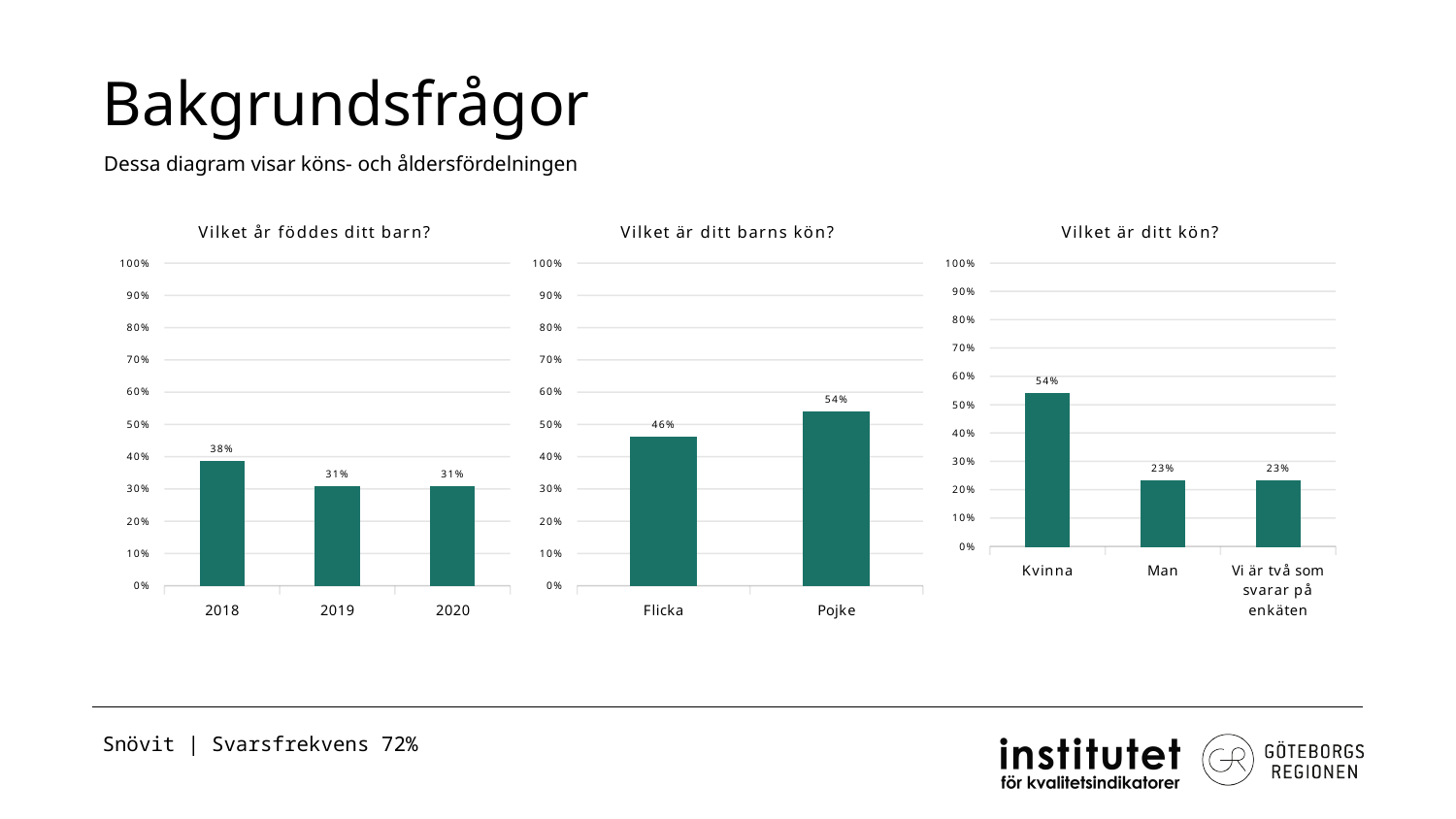
In the chart 'Vilket är ditt kön?', is the value for Kvinna greater or less than 50%? greater In the chart 'Vilket år föddes ditt barn?', which year has the highest value? 2018 In the chart 'Vilket är ditt barns kön?', what is the value for Flicka? 46% In the chart 'Vilket är ditt kön?', what is the value for Kvinna? 54% In the chart 'Vilket är ditt barns kön?', which category has the higher value, Flicka or Pojke? Pojke In the chart 'Vilket är ditt kön?', which category has the lowest value? Man and Vi är två som svarar på enkäten (both 23%) In the chart 'Vilket år föddes ditt barn?', what is the value for 2018? 38% In the chart 'Vilket är ditt kön?', what is the value for Man? 23% In the chart 'Vilket år föddes ditt barn?', what is the difference between the values for 2018 and 2019? 7% In the chart 'Vilket år föddes ditt barn?', how many years are shown? 3 What kind of chart is 'Vilket är ditt barns kön?'? Bar chart In the chart 'Vilket är ditt barns kön?', what is the difference between Pojke and Flicka? 8%